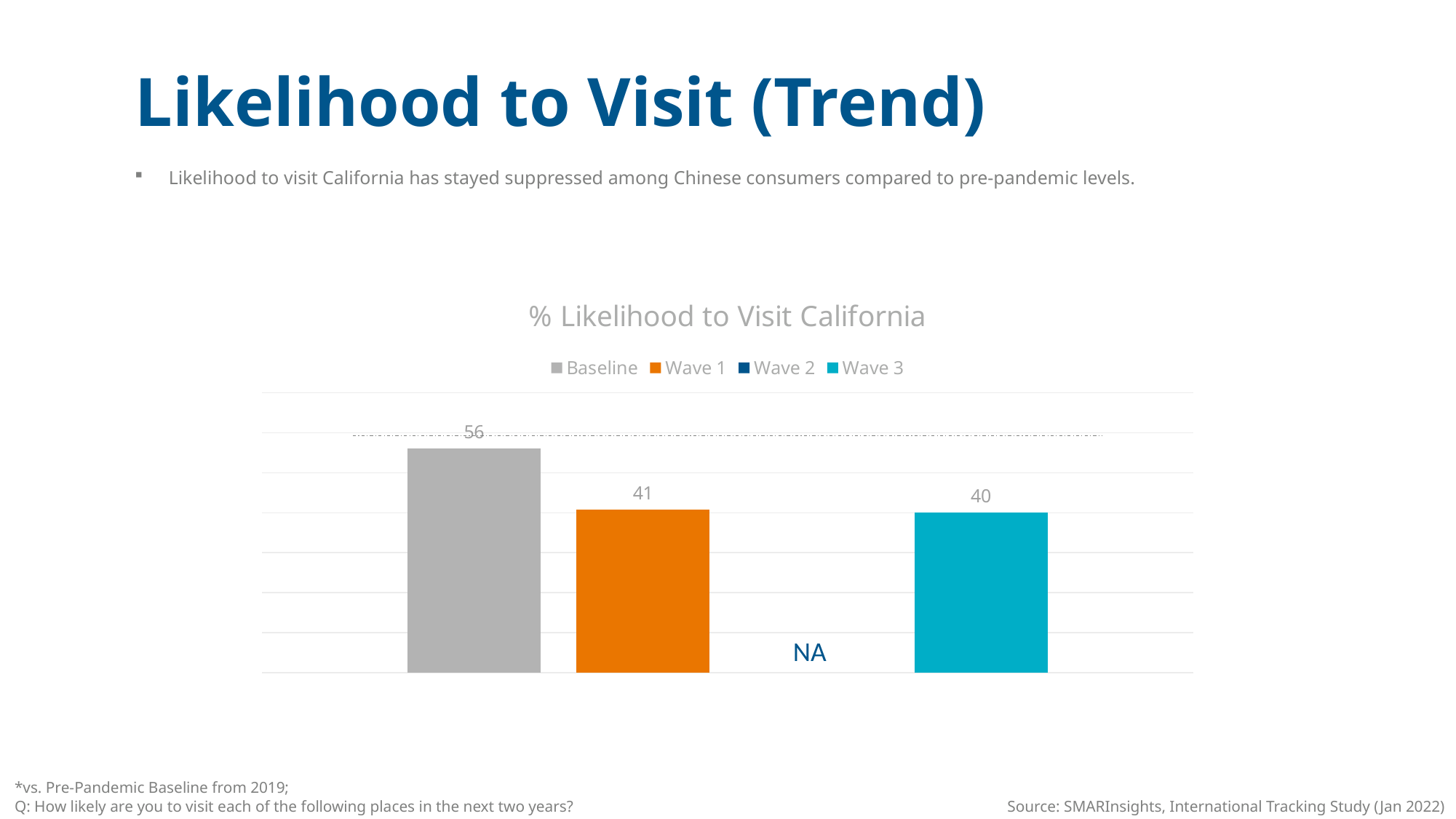
How many series does the legend list? 4 What kind of chart is shown on the slide? Bar chart Which is larger, the Baseline value or the Wave 3 value? Baseline What is the difference between the Baseline value and the Wave 1 value? 15 What is the difference between the Baseline value and the Wave 3 value? 16 What is shown for Wave 2 in the % Likelihood to Visit California chart? NA What colour is the Wave 1 bar? Orange What is the title of the chart? % Likelihood to Visit California What is the value for Wave 3 in the % Likelihood to Visit California chart? 40 What is the value for Baseline in the % Likelihood to Visit California chart? 56 Which series has the highest value in the % Likelihood to Visit California chart? Baseline What is the value for Wave 1 in the % Likelihood to Visit California chart? 41